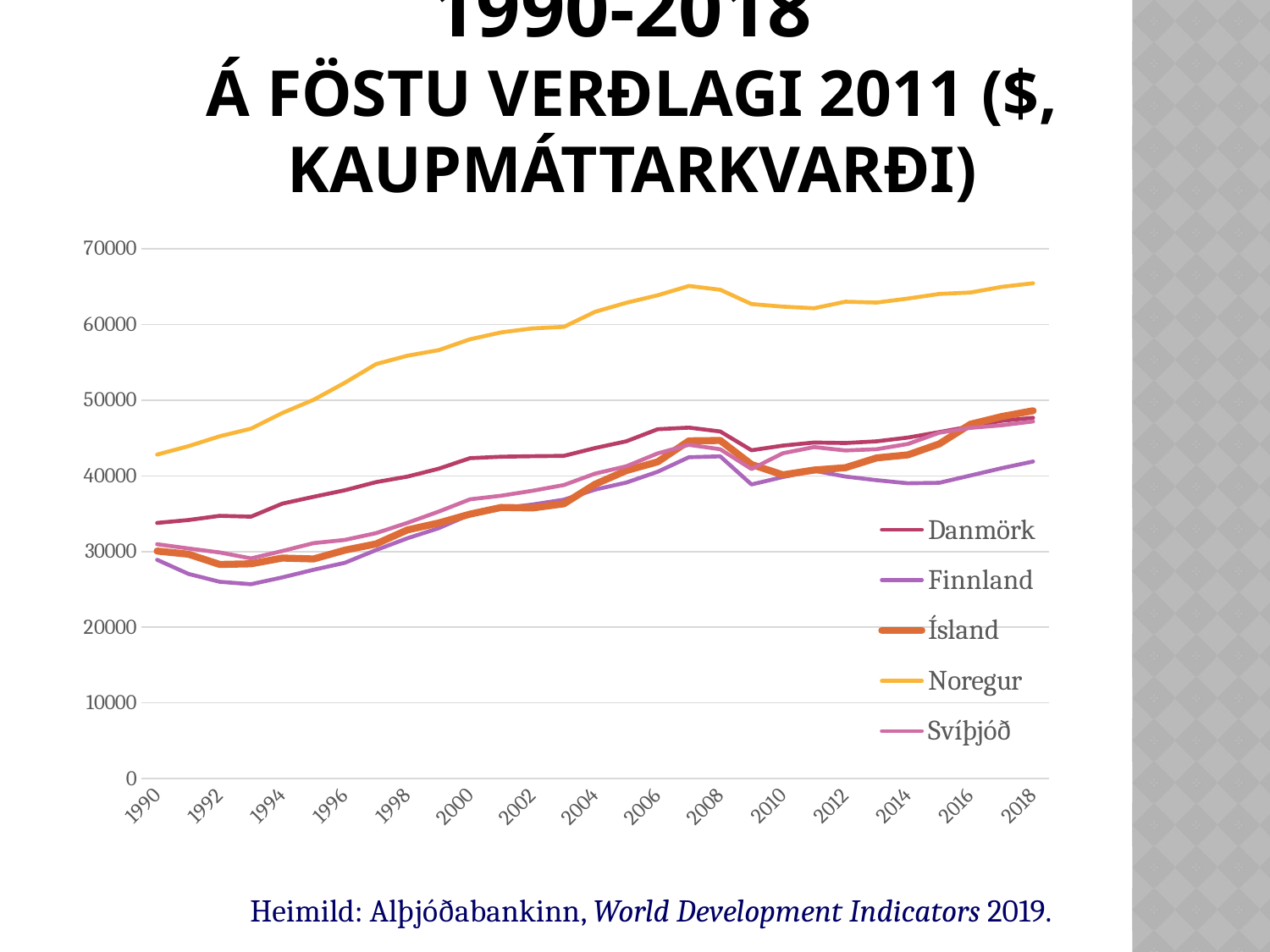
How many series does the legend list? 5 What are the entries listed in the legend? Danmörk, Finnland, Ísland, Noregur, Svíþjóð Which series has the lowest value in 2018? Finnland Does the value for Noregur generally rise or fall from 1990 to 2018? rise Is the value for Noregur in 2018 greater or less than 60000? greater Which series has the lowest value in 1992? Finnland How many year labels are shown on the x axis? 15 What kind of chart is shown on the slide? line chart Is the value for Finnland in 1992 greater or less than 30000? less Which series has the highest value in 2018? Noregur Which is larger in 2010, the value for Noregur or the value for Finnland? Noregur Is the value for Ísland in 2018 greater or less than 40000? greater